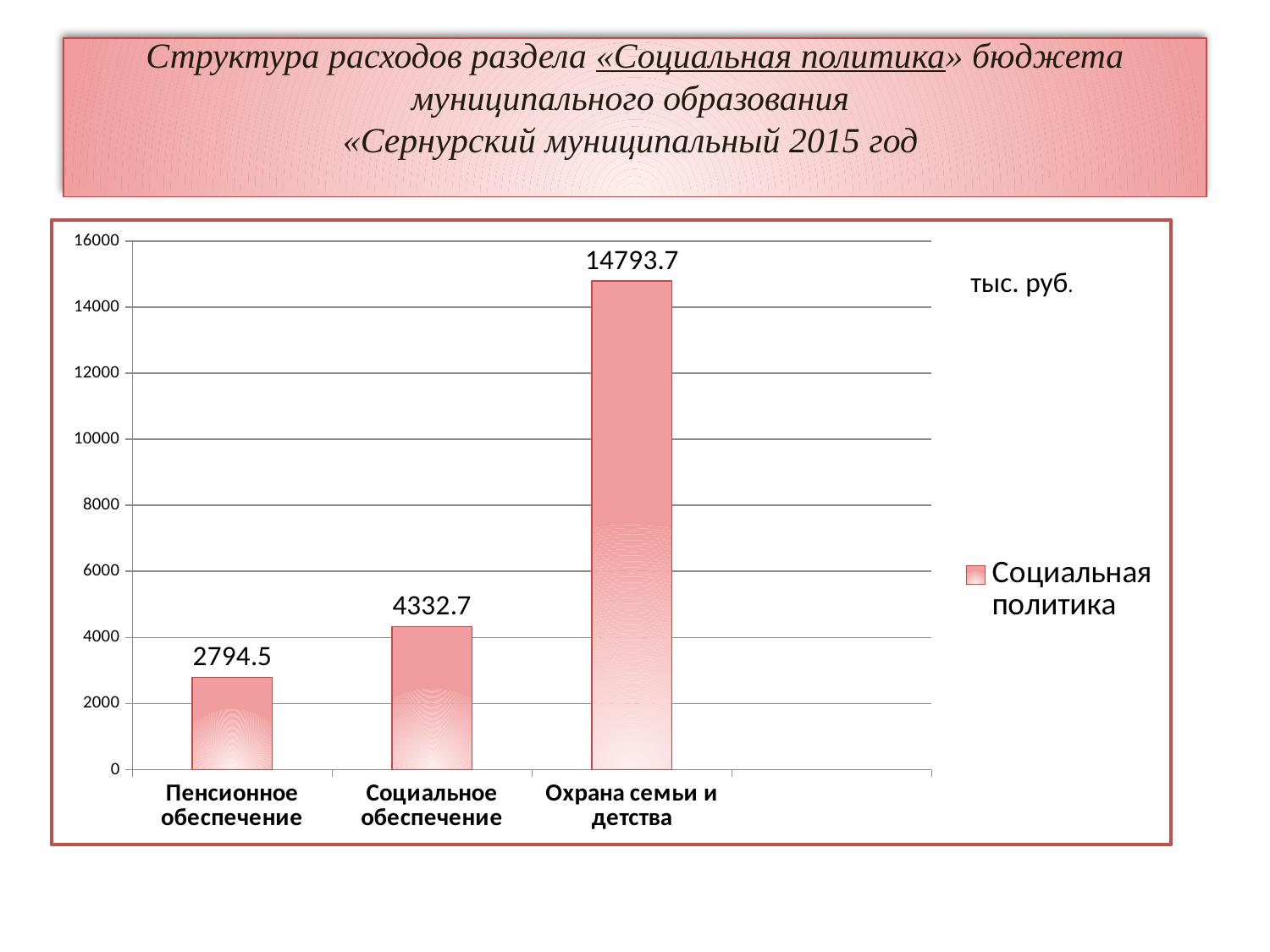
What is the value for Социальное обеспечение? 4332.7 What is the difference between the values for Охрана семьи и детства and Социальное обеспечение? 10461.0 Is the value for Охрана семьи и детства greater or less than 14000? greater How many categories are shown on the x axis? 3 Which category has the lowest value? Пенсионное обеспечение What is the value for Пенсионное обеспечение? 2794.5 What is the value for Охрана семьи и детства? 14793.7 How many series does the legend list? 1 Which category has the highest value? Охрана семьи и детства What kind of chart is shown on the slide? bar chart Which is larger, the value for Социальное обеспечение or the value for Пенсионное обеспечение? Социальное обеспечение What is the difference between the values for Социальное обеспечение and Пенсионное обеспечение? 1538.2